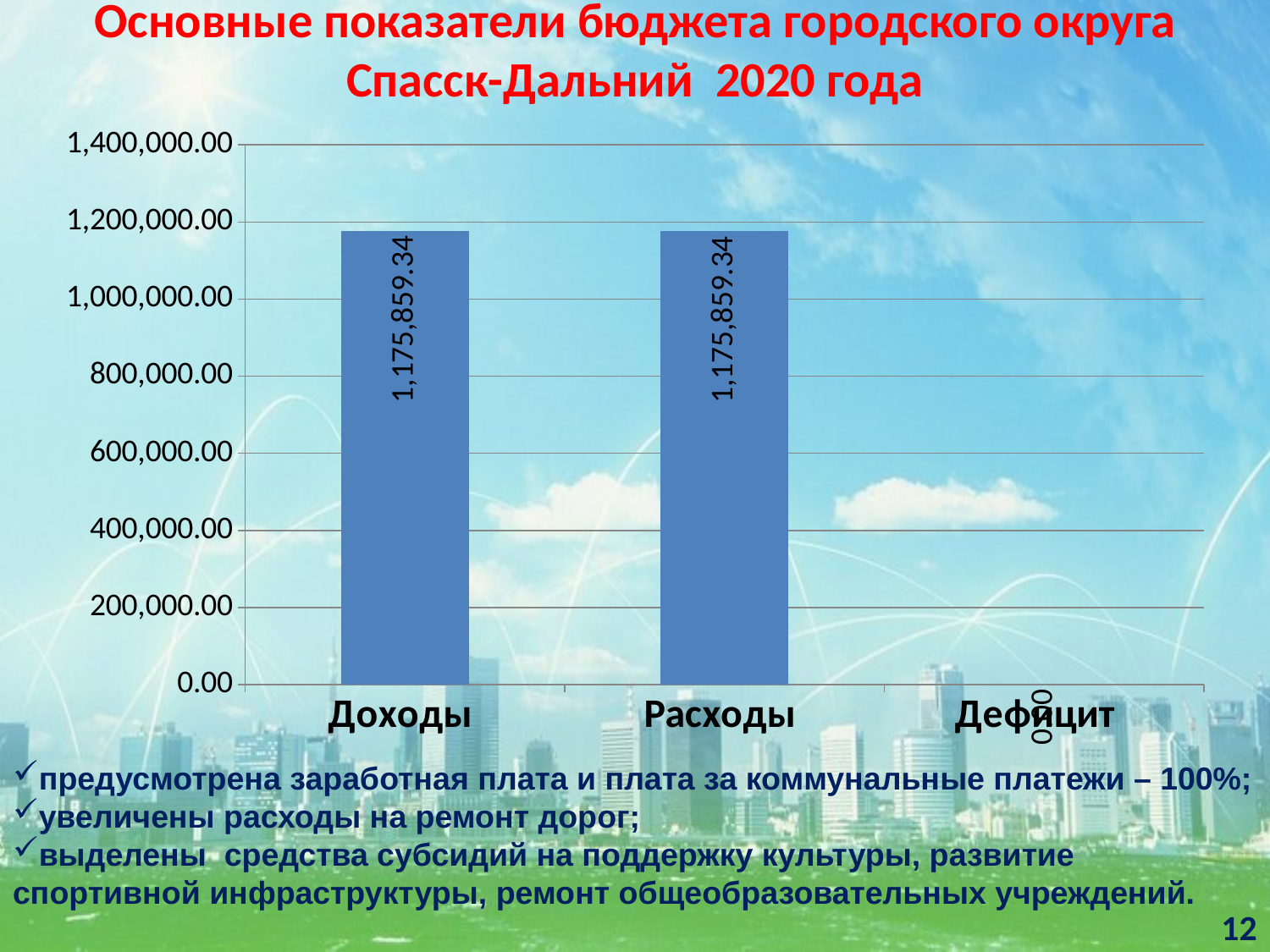
Is the value for Расходы greater or less than 1,200,000.00? less What is the value for Расходы? 1,175,859.34 What is the value for Доходы? 1,175,859.34 Is the value for Доходы larger than, smaller than, or equal to the value for Расходы? equal What is the value for Дефицит? 0.00 What is the difference between the values for Доходы and Дефицит? 1,175,859.34 Is the value for Доходы greater or less than 1,000,000.00? greater What is the title of the slide? Основные показатели бюджета городского округа Спасск-Дальний 2020 года What is the difference between the values for Доходы and Расходы? 0.00 How many categories are shown on the x axis? 3 Which category has the lowest value? Дефицит What kind of chart is shown on the slide? bar chart